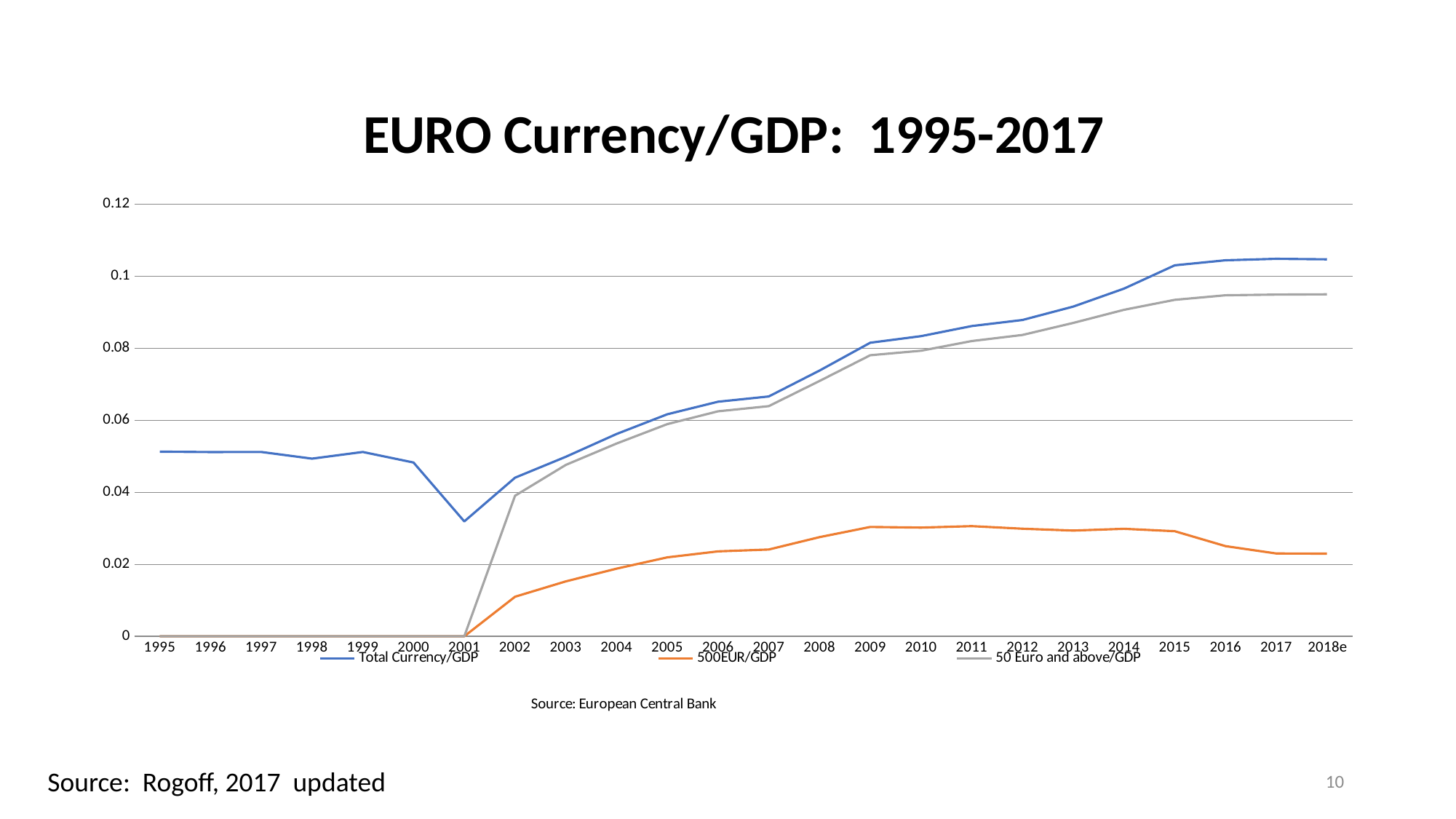
What kind of chart is shown on the slide? line chart Which is larger in 2010: 500EUR/GDP or 50 Euro and above/GDP? 50 Euro and above/GDP Is the value of 50 Euro and above/GDP in 2015 greater or less than 0.08? greater How many years (points) are shown along the x axis? 24 Is the value of Total Currency/GDP in 2001 greater or less than 0.04? less In which year is the Total Currency/GDP line at its lowest? 2001 Is the value of 500EUR/GDP in 2009 greater or less than 0.04? less Which series has the highest value in 2018e? Total Currency/GDP Does the Total Currency/GDP line rise or fall between 2001 and 2015? rise What is the title of the chart? EURO Currency/GDP: 1995-2017 How many series does the legend list? 3